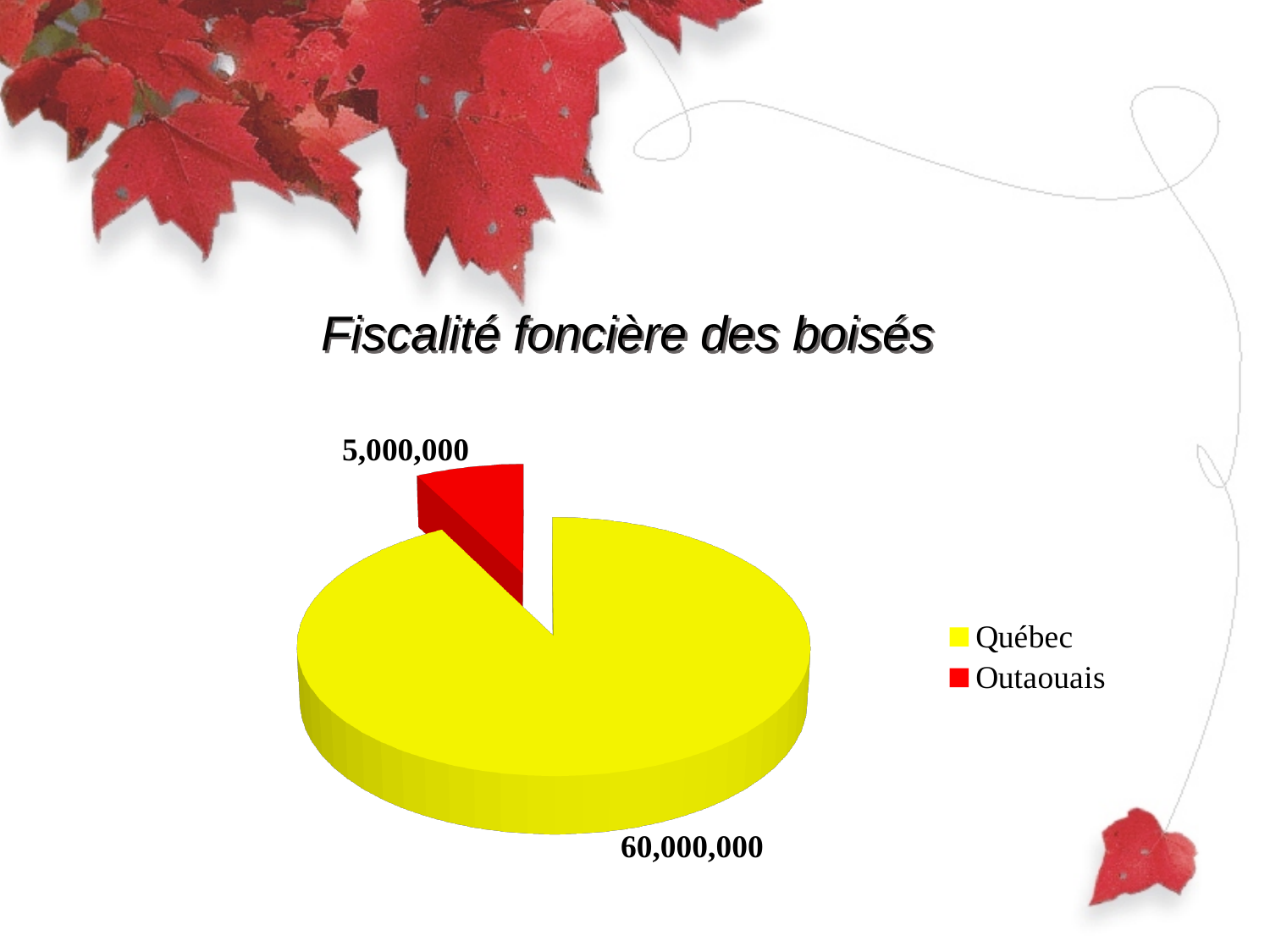
What is the total of the two values shown in the pie chart? 65,000,000 Which category has the smallest slice in the pie chart? Outaouais What is the difference between the values for Québec and Outaouais? 55,000,000 Which category has the largest slice in the pie chart? Québec What colour is the Outaouais slice in the pie chart? red Which is larger, the value for Québec or the value for Outaouais? Québec What is the title of the slide above the pie chart? Fiscalité foncière des boisés How many entries does the legend list? 2 How many slices does the pie chart have? 2 What is the value for Outaouais in the pie chart? 5,000,000 What type of chart is shown on the slide? pie chart What is the value for Québec in the pie chart? 60,000,000